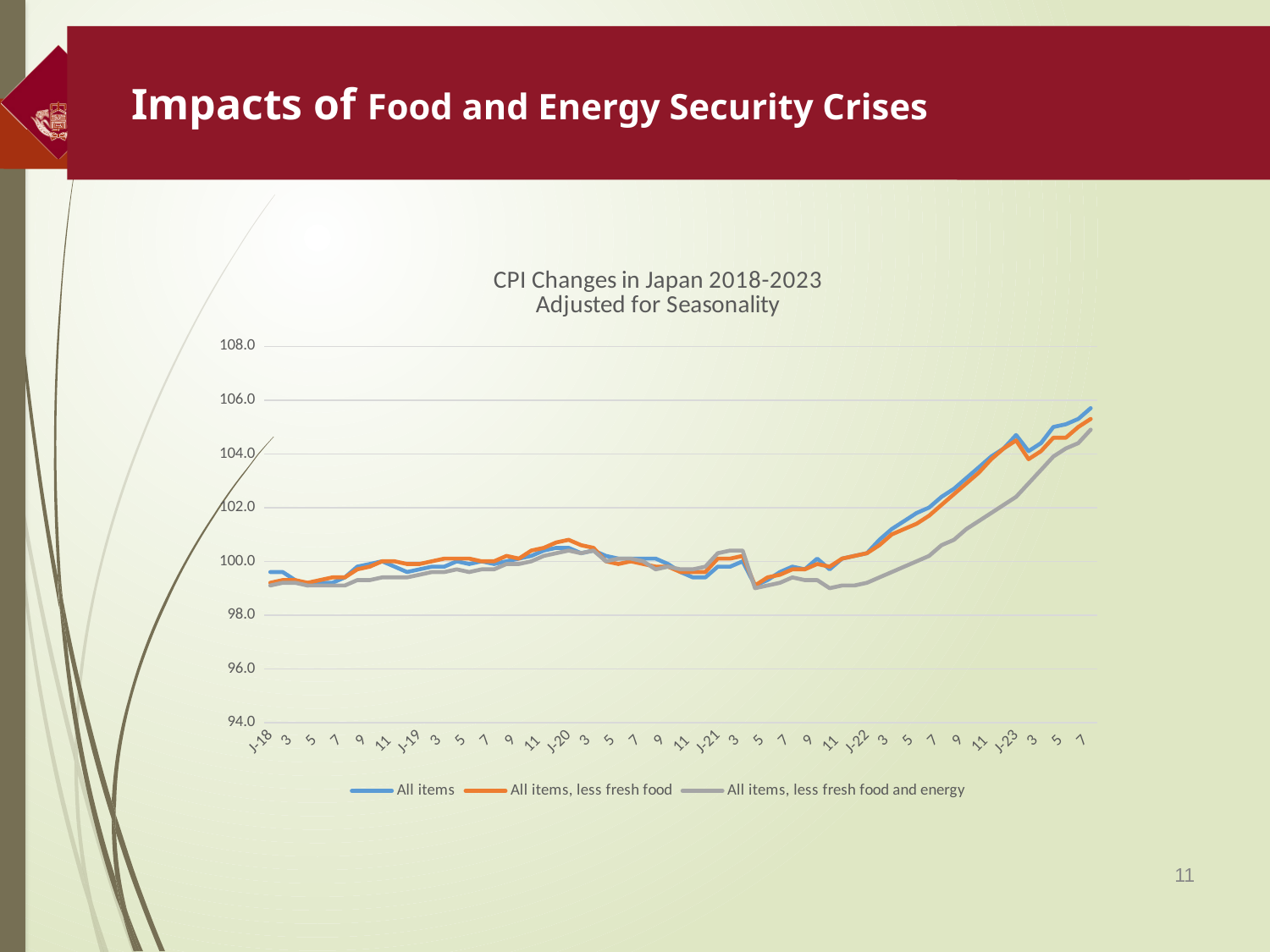
Overall, do the CPI values rise or fall from J-18 to the last point in 2023? rise At the last point (7 of 2023), which is higher: 'All items' or 'All items, less fresh food and energy'? All items Which series has the highest value at the last point (7 of 2023)? All items Is the value for 'All items, less fresh food and energy' at J-23 greater or less than 100.0? greater Is the value for 'All items' at month 5 of 2021 greater or less than 100.0? less Is the value for 'All items, less fresh food and energy' at J-18 greater or less than 100.0? less Which series has the lowest value at the last point (7 of 2023)? All items, less fresh food and energy What kind of chart is shown on the slide? line chart What is the title of the chart? CPI Changes in Japan 2018-2023 Adjusted for Seasonality Which colour is used for the 'All items, less fresh food and energy' series? grey How many series does the legend list? 3